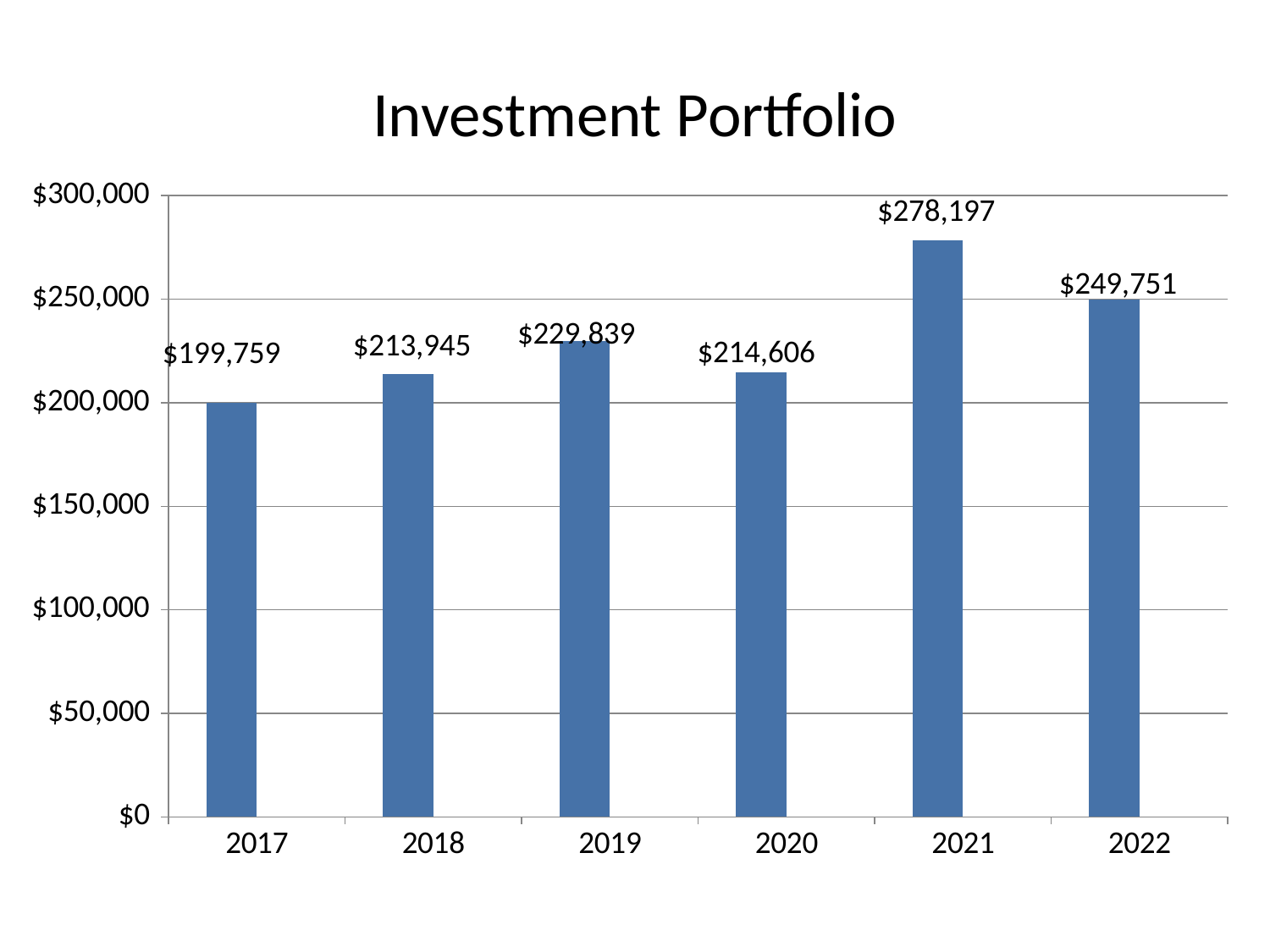
How many years are shown on the x axis? 6 What is the difference between the values for 2018 and 2017? $14,186 Which year has the lowest value? 2017 What is the value for 2017? $199,759 Which year has the highest value? 2021 What is the value for 2022? $249,751 What is the title of the chart? Investment Portfolio Is the value for 2021 greater or less than $250,000? greater Which is larger, the value for 2019 or the value for 2020? 2019 What kind of chart is shown? bar chart What is the difference between the values for 2021 and 2022? $28,446 What is the value for 2020? $214,606